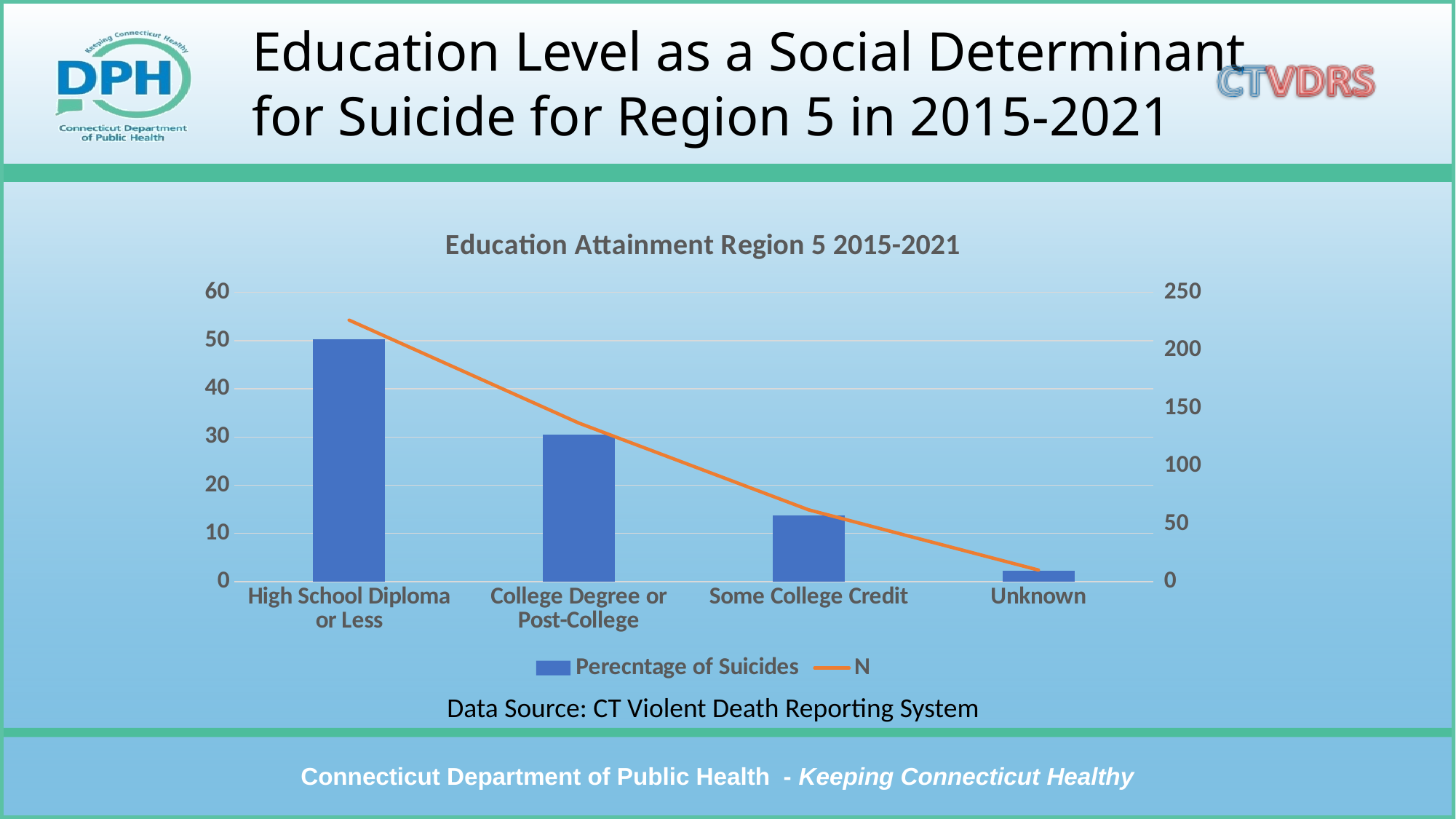
Which has a higher percentage of suicides: College Degree or Post-College, or Some College Credit? College Degree or Post-College Do the N values rise or fall from left to right across the categories? fall Is the N value for Unknown greater or less than 50? less Is the percentage of suicides for College Degree or Post-College greater or less than 20? greater Which category has the highest percentage of suicides? High School Diploma or Less What kind of chart is used for the Percentage of Suicides series? bar chart How many education categories are shown on the x axis? 4 Is the N value for High School Diploma or Less greater or less than 200? greater Which category has the lowest percentage of suicides? Unknown How many series does the legend list? 2